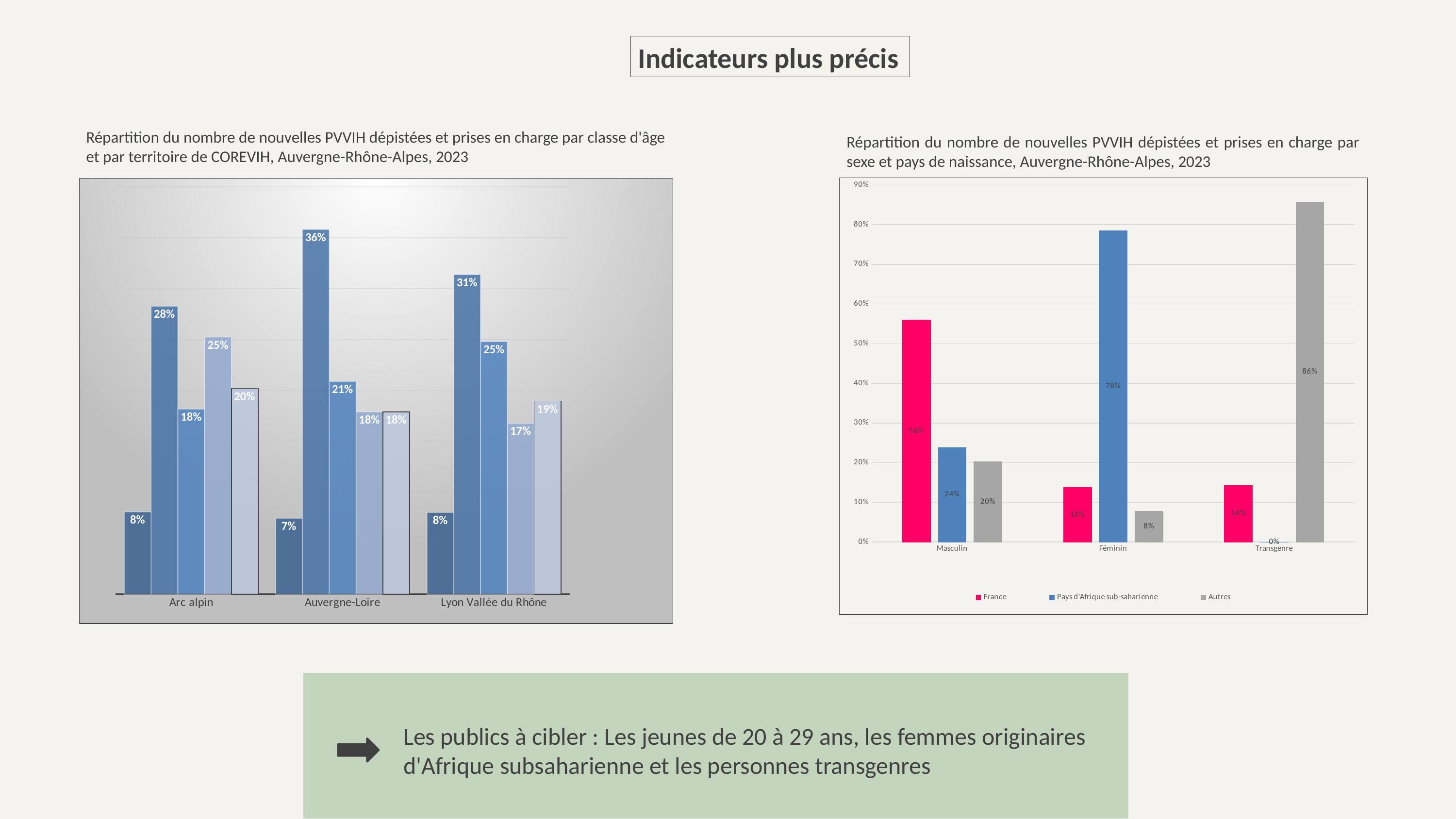
In the right chart (by sexe et pays de naissance), what is the value for Autres in the Transgenre category? 86% In the left chart (by classe d'âge et territoire de COREVIH), what is the lowest value shown for Lyon Vallée du Rhône? 8% In the right chart (by sexe et pays de naissance), how many series does the legend list? 3 In the right chart (by sexe et pays de naissance), what is the difference between the Autres value for Masculin and the Autres value for Féminin? 12% In the right chart (by sexe et pays de naissance), what is the value for France in the Masculin category? 56% What kind of chart is the left chart (by classe d'âge et territoire de COREVIH)? bar chart In the right chart (by sexe et pays de naissance), which is larger: France for Féminin or Pays d'Afrique sub-saharienne for Masculin? Pays d'Afrique sub-saharienne for Masculin In the right chart (by sexe et pays de naissance), which series has the highest value in the Masculin category? France In the left chart (by classe d'âge et territoire de COREVIH), how many territories are shown on the x axis? 3 In the left chart (by classe d'âge et territoire de COREVIH), what is the highest value shown for Auvergne-Loire? 36% In the right chart (by sexe et pays de naissance), what is the value for Pays d'Afrique sub-saharienne in the Féminin category? 78% In the right chart (by sexe et pays de naissance), what is the value for Pays d'Afrique sub-saharienne in the Transgenre category? 0%